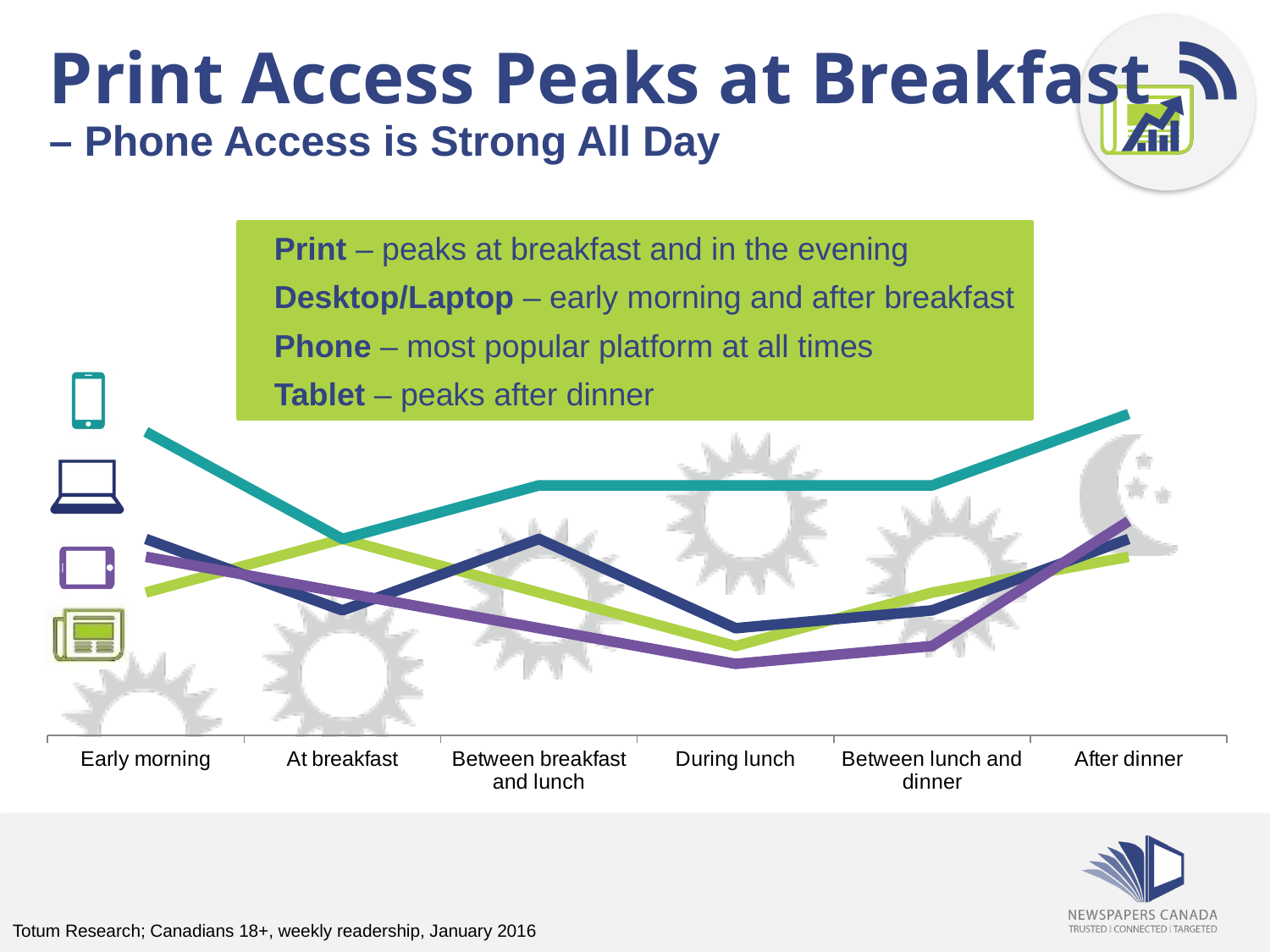
Does the phone (teal) line rise or fall from During lunch to After dinner? Rise How many time-of-day categories are shown on the x axis? 6 At which time of day is the phone (teal) line at its lowest? At breakfast How many lines (platforms) are plotted on the chart? 4 At which time of day is the tablet (purple) line at its highest? After dinner Which line is higher at Early morning, the phone (teal) line or the print (green) line? Phone (teal) Which platform's line is the highest at every time of day? Phone What is the main title of the slide? Print Access Peaks at Breakfast What kind of chart is shown on the slide? Line chart At which time of day is the phone (teal) line at its highest? After dinner At which time of day is the tablet (purple) line at its lowest? During lunch At which time of day is the print (green) line at its lowest? During lunch